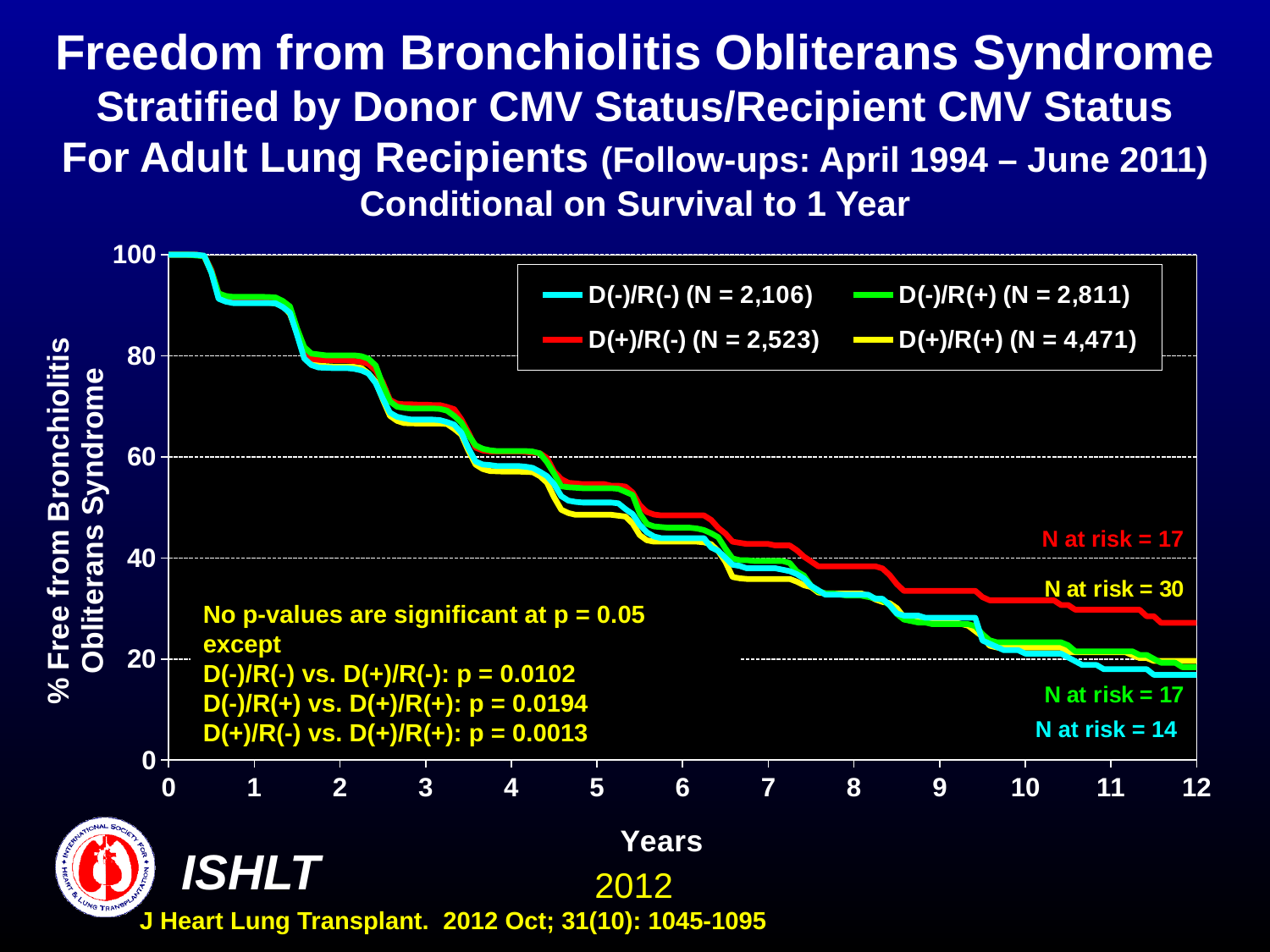
Which curve is highest at 12 years? D(+)/R(-) Do the curves rise or fall as years increase? fall Is the value for D(+)/R(-) at 12 years greater or less than 20? greater How many series does the legend list? 4 What is the p-value shown for D(+)/R(-) vs. D(+)/R(+)? p = 0.0013 Which group has the largest N in the legend? D(+)/R(+) Is the value for D(-)/R(-) at 8 years greater or less than 40? less What is the difference between the N for D(+)/R(+) and the N for D(-)/R(-)? 2,365 What is the N for the D(+)/R(+) group shown in the legend? 4,471 At 12 years, which is larger: the D(+)/R(-) curve or the D(-)/R(-) curve? D(+)/R(-) What kind of chart is shown on the slide? line chart What is the N for the D(-)/R(-) group shown in the legend? 2,106